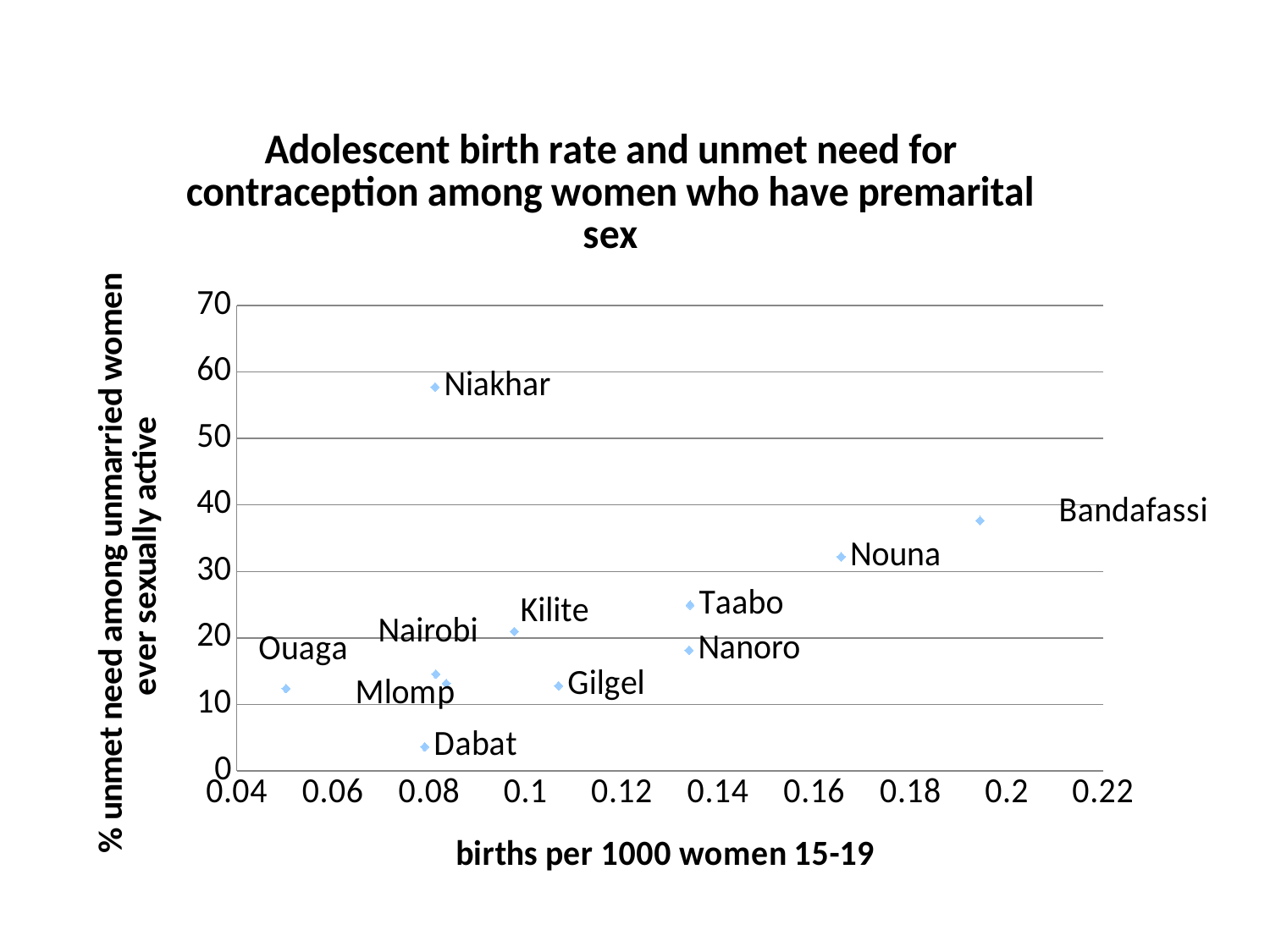
Which site has the lowest % unmet need among unmarried women ever sexually active? Dabat Which site has the highest adolescent birth rate (births per 1000 women 15-19)? Bandafassi Which site has a higher % unmet need, Niakhar or Nouna? Niakhar Is the % unmet need for Niakhar greater or less than 50? greater Which site has a higher % unmet need, Taabo or Nanoro? Taabo How many labelled data points are plotted on the chart? 11 Which site has the highest % unmet need among unmarried women ever sexually active? Niakhar Is the % unmet need for Dabat greater or less than 10? less Which site has the lowest adolescent birth rate (births per 1000 women 15-19)? Ouaga What is the title of the x axis? births per 1000 women 15-19 What kind of chart is shown on the slide? scatter chart Is the % unmet need for Bandafassi greater or less than 40? less